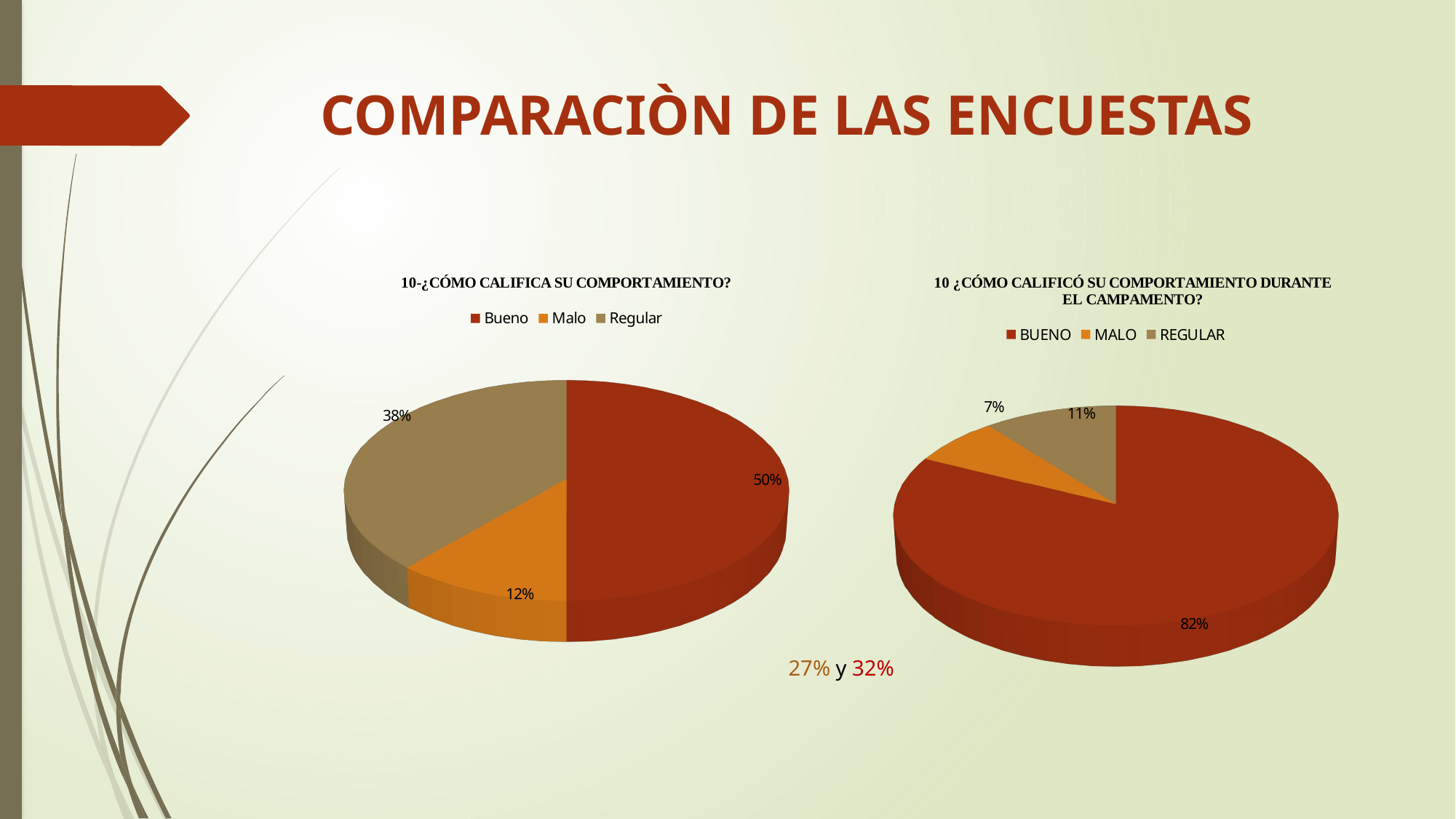
In the left pie chart, what is the difference between the Bueno and Regular percentages? 12% In the left pie chart titled "10-¿CÓMO CALIFICA SU COMPORTAMIENTO?", what percentage is shown for Regular? 38% What type of chart is used on the left side of the slide? Pie chart In the left pie chart titled "10-¿CÓMO CALIFICA SU COMPORTAMIENTO?", what percentage is shown for Malo? 12% In the right pie chart, which category has the largest slice? BUENO In the right pie chart, is the REGULAR slice larger or smaller than the MALO slice? larger In the right pie chart titled "10 ¿CÓMO CALIFICÓ SU COMPORTAMIENTO DURANTE EL CAMPAMENTO?", what percentage is shown for BUENO? 82% In the left pie chart, which category has the smallest slice? Malo In the right pie chart titled "10 ¿CÓMO CALIFICÓ SU COMPORTAMIENTO DURANTE EL CAMPAMENTO?", what percentage is shown for REGULAR? 11% In the left pie chart titled "10-¿CÓMO CALIFICA SU COMPORTAMIENTO?", what percentage is shown for Bueno? 50% In the right pie chart titled "10 ¿CÓMO CALIFICÓ SU COMPORTAMIENTO DURANTE EL CAMPAMENTO?", what percentage is shown for MALO? 7% How many categories does the legend of the right pie chart list? 3